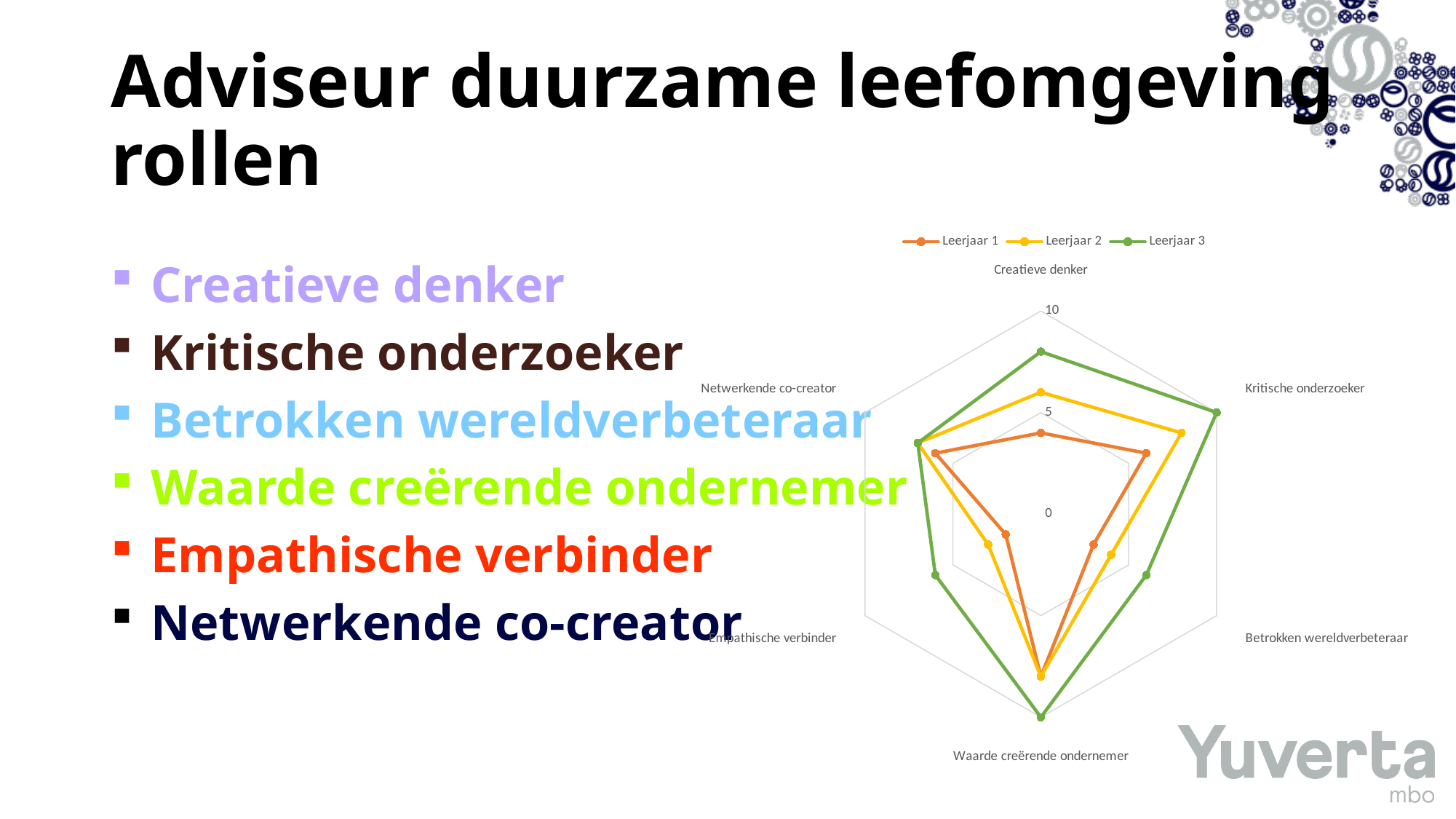
For which category does Leerjaar 1 have its highest value? Waarde creërende ondernemer Is the value of Leerjaar 2 for Kritische onderzoeker greater or less than 5? greater For Creatieve denker, which is larger: the value of Leerjaar 1 or Leerjaar 3? Leerjaar 3 How many series does the chart legend list? 3 Which series are listed in the chart legend? Leerjaar 1, Leerjaar 2, Leerjaar 3 How many categories (axes) does the radar chart have? 6 What is the highest value shown on the chart's radial axis? 10 Which series has the highest value for Kritische onderzoeker? Leerjaar 3 Is the value of Leerjaar 3 for Creatieve denker greater or less than 5? greater What kind of chart is shown on the slide? Radar chart Is the value of Leerjaar 1 for Creatieve denker greater or less than 5? less